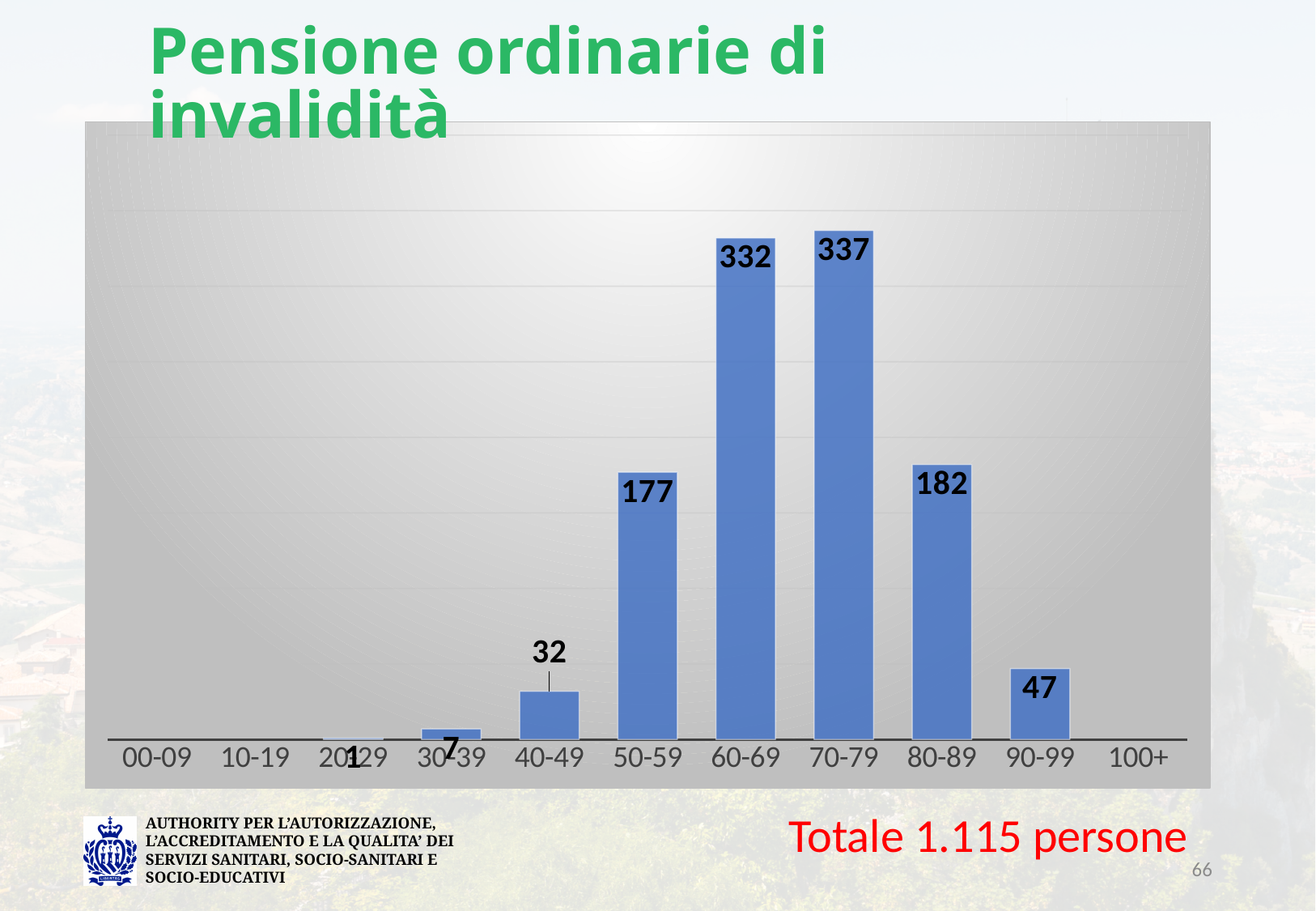
Which is larger, the value for 50-59 or the value for 80-89? 80-89 What total number of people is stated below the chart? 1.115 persone What is the difference between the values for 70-79 and 60-69? 5 Which age group has the highest value? 70-79 Among the age groups with a data label, which has the lowest value? 20-29 What is the value for the 40-49 age group? 32 What kind of chart is shown on the slide? Bar chart What is the value for the 80-89 age group? 182 How many age-group categories are shown on the x axis? 11 What is the value for the 90-99 age group? 47 What is the difference between the values for 80-89 and 50-59? 5 What is the value for the 60-69 age group? 332